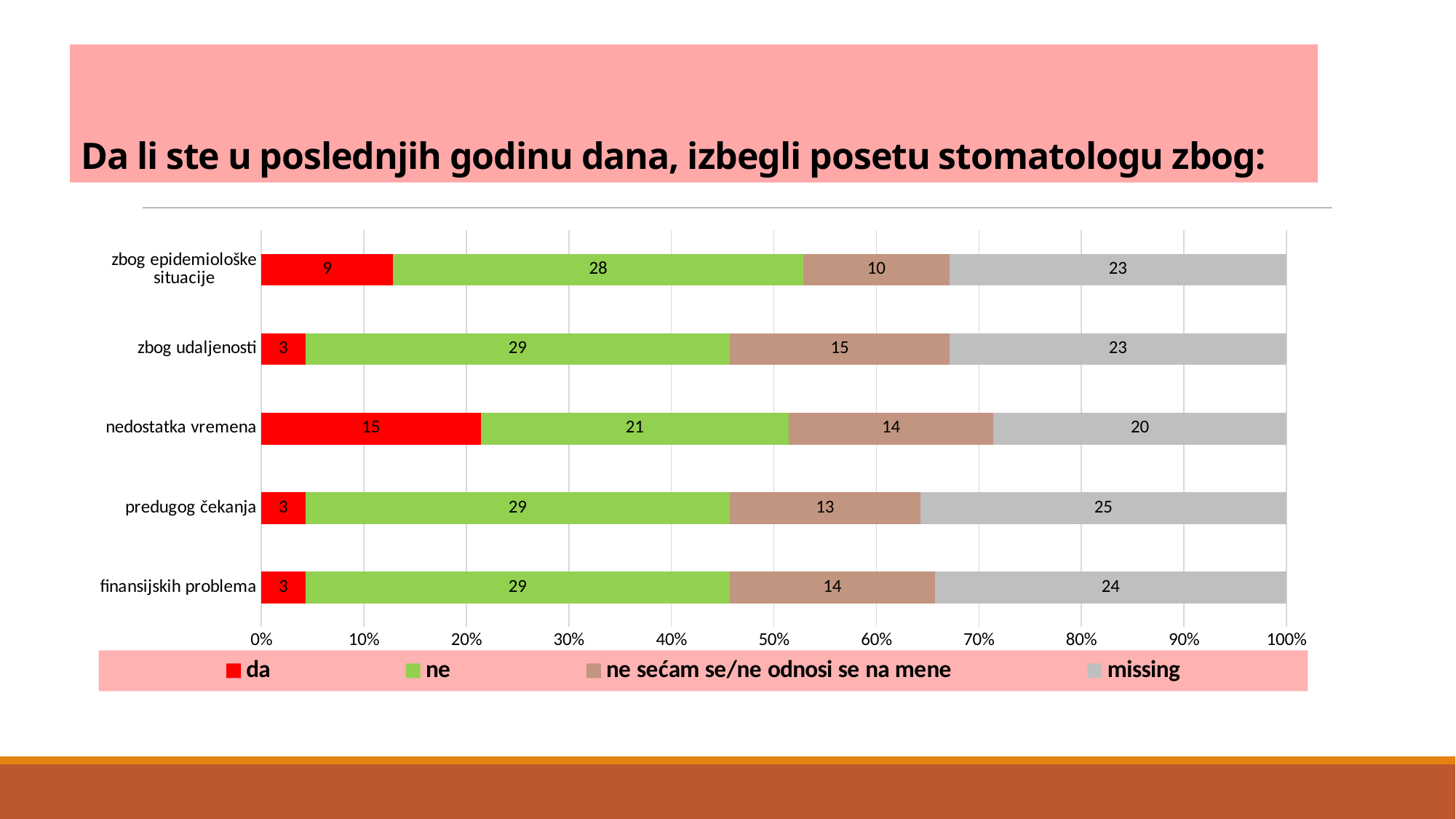
What is the value of the 'ne' series for 'zbog epidemiološke situacije'? 28 How many categories are shown on the vertical axis? 5 Which category has the lowest value for the 'missing' series? nedostatka vremena What kind of chart is shown on the slide? stacked bar chart What is the value of the 'da' series for 'nedostatka vremena'? 15 What is the total of all segments in the 'finansijskih problema' bar? 70 What is the value of the 'missing' series for 'predugog čekanja'? 25 What is the difference between the 'da' values for 'nedostatka vremena' and 'zbog epidemiološke situacije'? 6 What is the value of the 'ne sećam se/ne odnosi se na mene' series for 'zbog udaljenosti'? 15 Which category has the highest value for the 'da' series? nedostatka vremena Which is larger: the 'ne sećam se/ne odnosi se na mene' value for 'zbog udaljenosti' or for 'zbog epidemiološke situacije'? zbog udaljenosti How many series does the legend list? 4